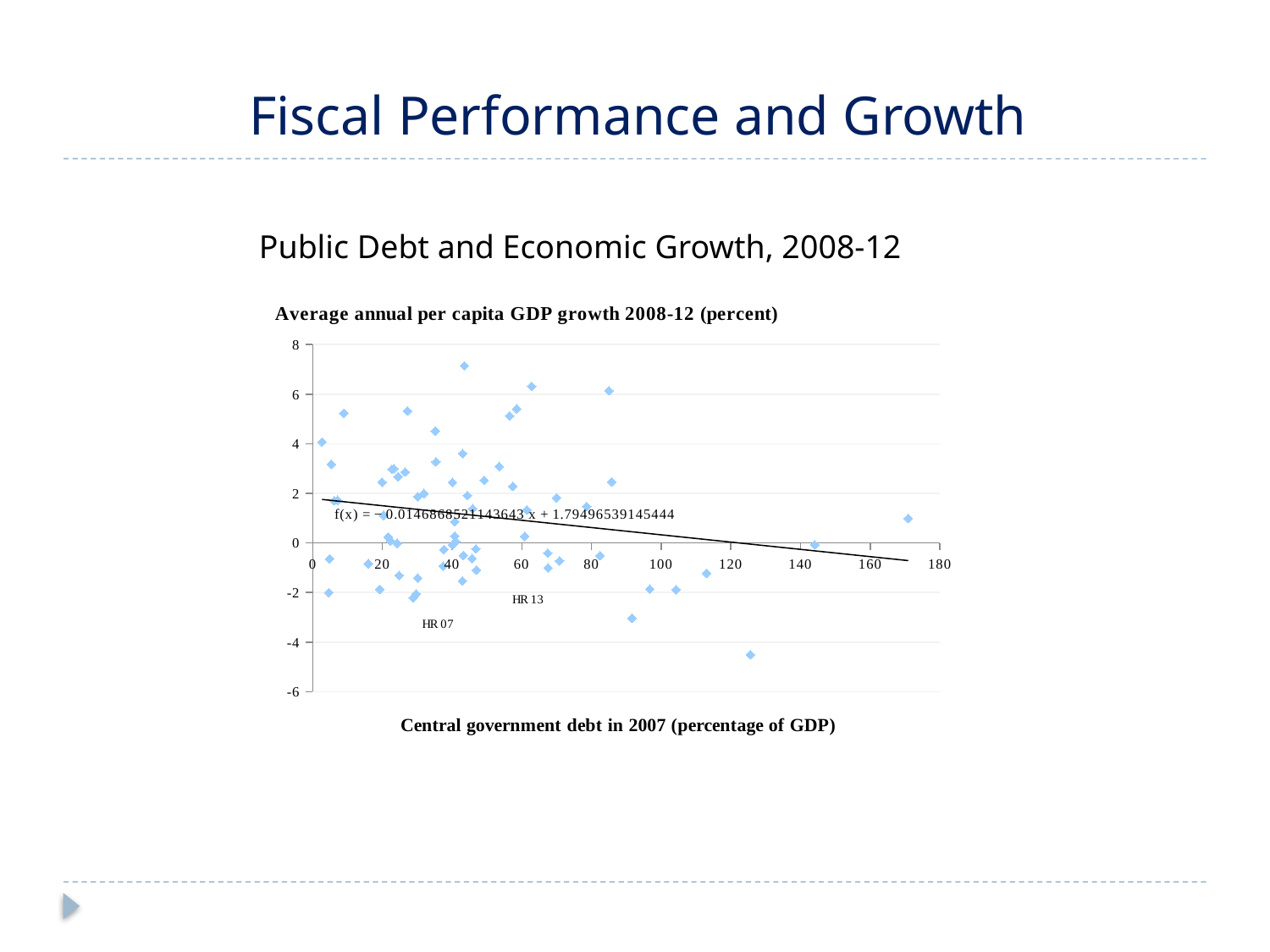
Does the fitted trend line rise or fall as central government debt increases? Falls What is the slope of the fitted line f(x) printed on the chart? −0.0146868521143643 What kind of chart is shown on the slide? Scatter chart What is the minimum value shown on the vertical axis? -6 Is the lowest per capita GDP growth value plotted greater or less than -4? less What is the label of the horizontal axis? Central government debt in 2007 (percentage of GDP) Is the highest per capita GDP growth value plotted greater or less than 6? greater Is the largest central government debt value plotted greater or less than 160? greater What is the intercept of the fitted line f(x) printed on the chart? 1.79496539145444 What is the maximum value shown on the horizontal axis? 180 What is the title of the chart? Public Debt and Economic Growth, 2008-12